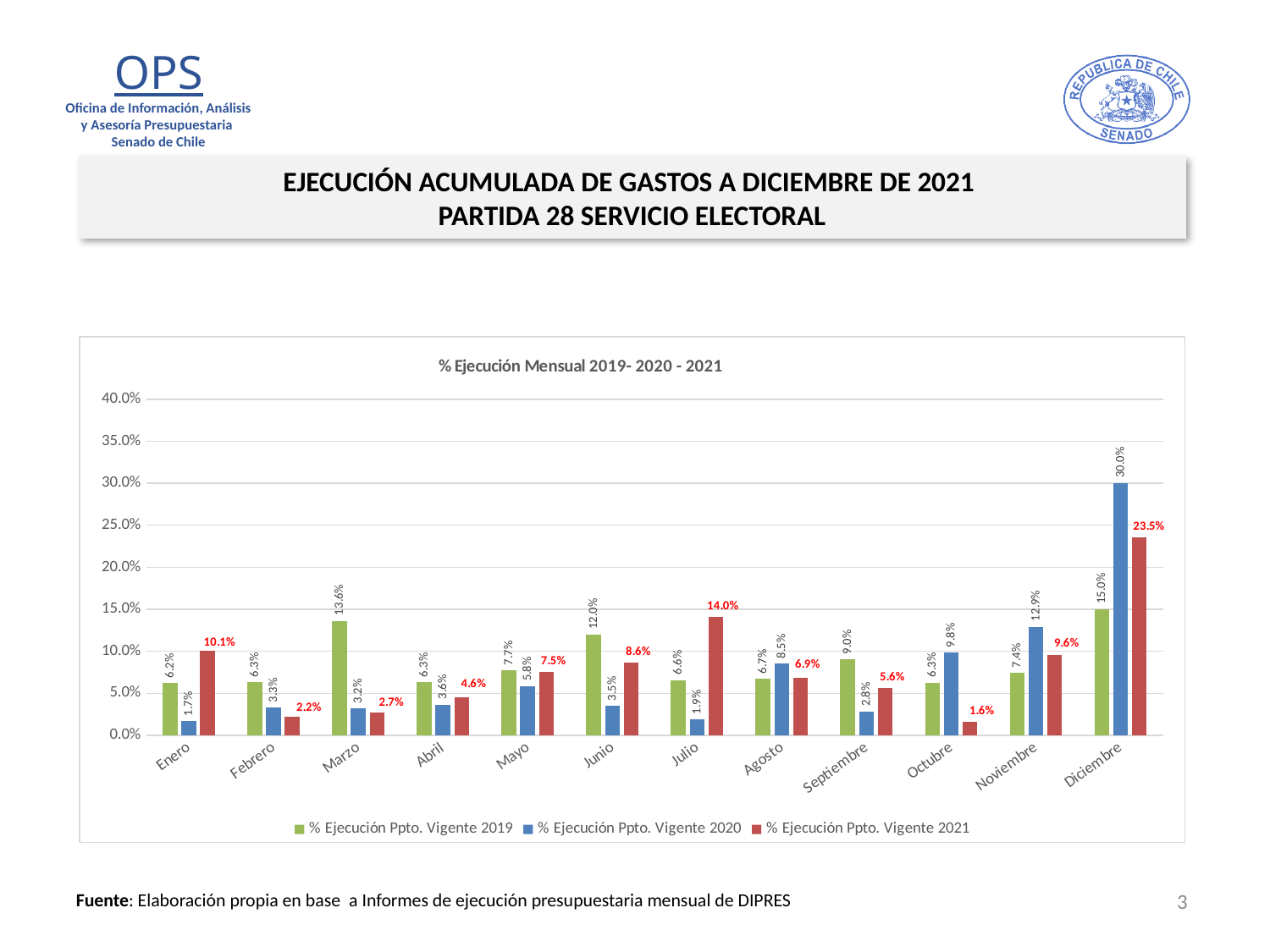
What is the difference between the 2020 and 2021 values for Diciembre? 6.5% What is the value for Marzo in the % Ejecución Ppto. Vigente 2019 series? 13.6% Which is larger for Agosto: the 2019 value or the 2020 value? 2020 What is the title of the chart? % Ejecución Mensual 2019- 2020 - 2021 How many months are shown on the x axis? 12 What is the value for Julio in the % Ejecución Ppto. Vigente 2021 series? 14.0% Is the value for Diciembre in the 2020 series greater or less than 25.0%? greater Which month has the lowest value in the % Ejecución Ppto. Vigente 2021 series? Octubre Which month has the highest value in the % Ejecución Ppto. Vigente 2021 series? Diciembre What kind of chart is shown on the slide? Bar chart What is the value for Diciembre in the % Ejecución Ppto. Vigente 2020 series? 30.0% How many series does the legend list? 3